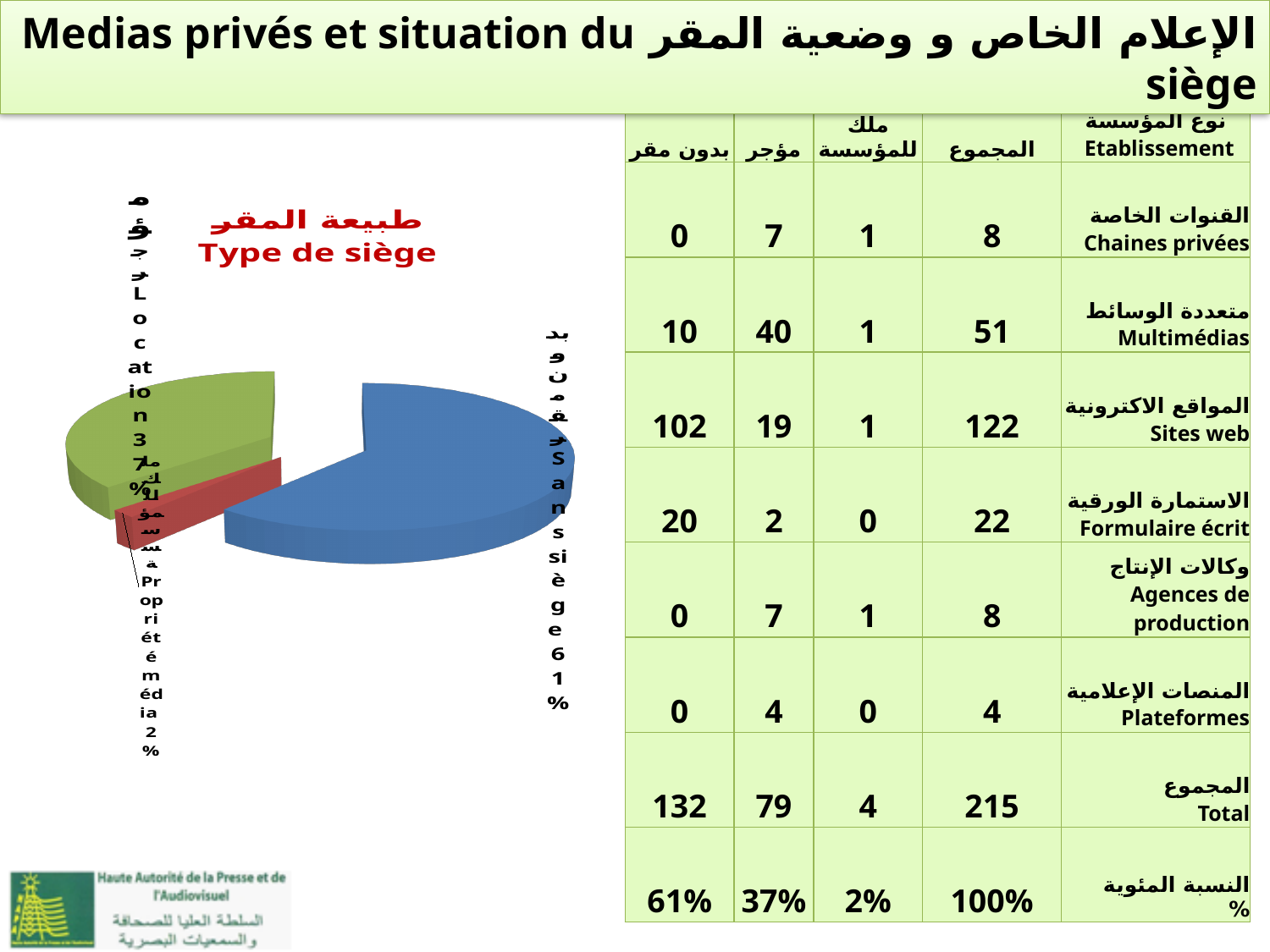
What is the difference in percentage points between the 'Sans siège' and 'Location' slices? 24 percentage points How many slices does the pie chart have? 3 What share of the pie does the 'Sans siège' slice represent? 61% What is the difference in percentage points between the 'Location' and 'Propriété média' slices? 35 percentage points Which is larger in the pie chart, 'Sans siège' or 'Location'? Sans siège What share of the pie does the 'Location' slice represent? 37% What kind of chart is shown on the slide? Pie chart Which slice of the pie chart is the largest? Sans siège What share of the pie does the 'Propriété média' slice represent? 2% What is the French title of the pie chart? Type de siège What colour is the largest slice of the pie chart? Blue Which slice of the pie chart is the smallest? Propriété média